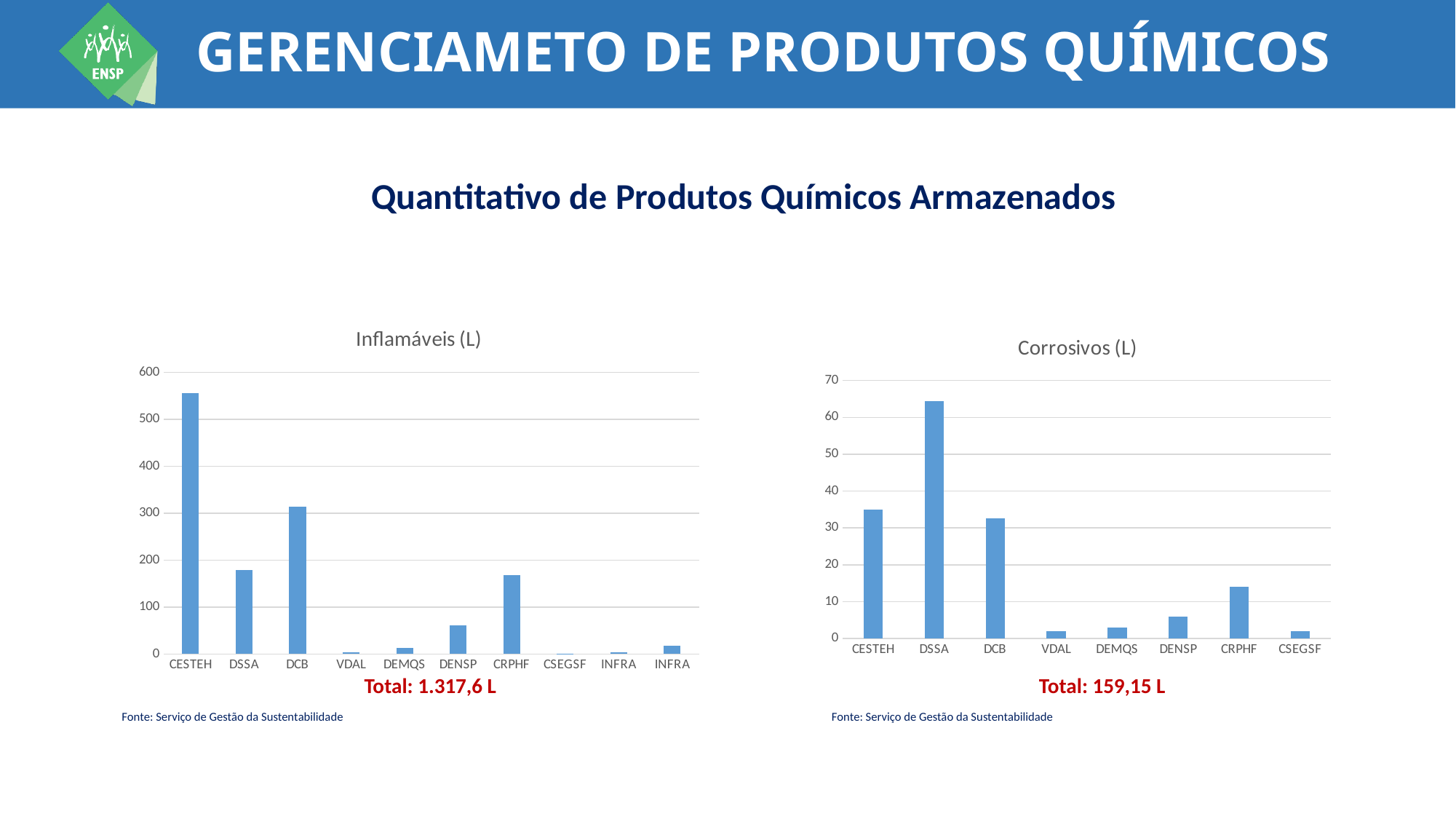
In the "Inflamáveis (L)" chart, which is larger, the value for DSSA or the value for DENSP? DSSA In the "Corrosivos (L)" chart, which category has the highest value? DSSA In the "Inflamáveis (L)" chart, which category has the highest value? CESTEH In the "Inflamáveis (L)" chart, is the value for CESTEH greater or less than 500? greater In the "Inflamáveis (L)" chart, is the value for DCB greater or less than 300? greater In the "Corrosivos (L)" chart, is the value for DSSA greater or less than 60? greater How many categories are shown on the x axis of the "Corrosivos (L)" chart? 8 What kind of chart is the "Inflamáveis (L)" chart on the left? bar chart In the "Corrosivos (L)" chart, which is larger, the value for CESTEH or the value for DENSP? CESTEH How many categories are shown on the x axis of the "Inflamáveis (L)" chart? 10 What total is printed below the "Corrosivos (L)" chart? 159,15 L